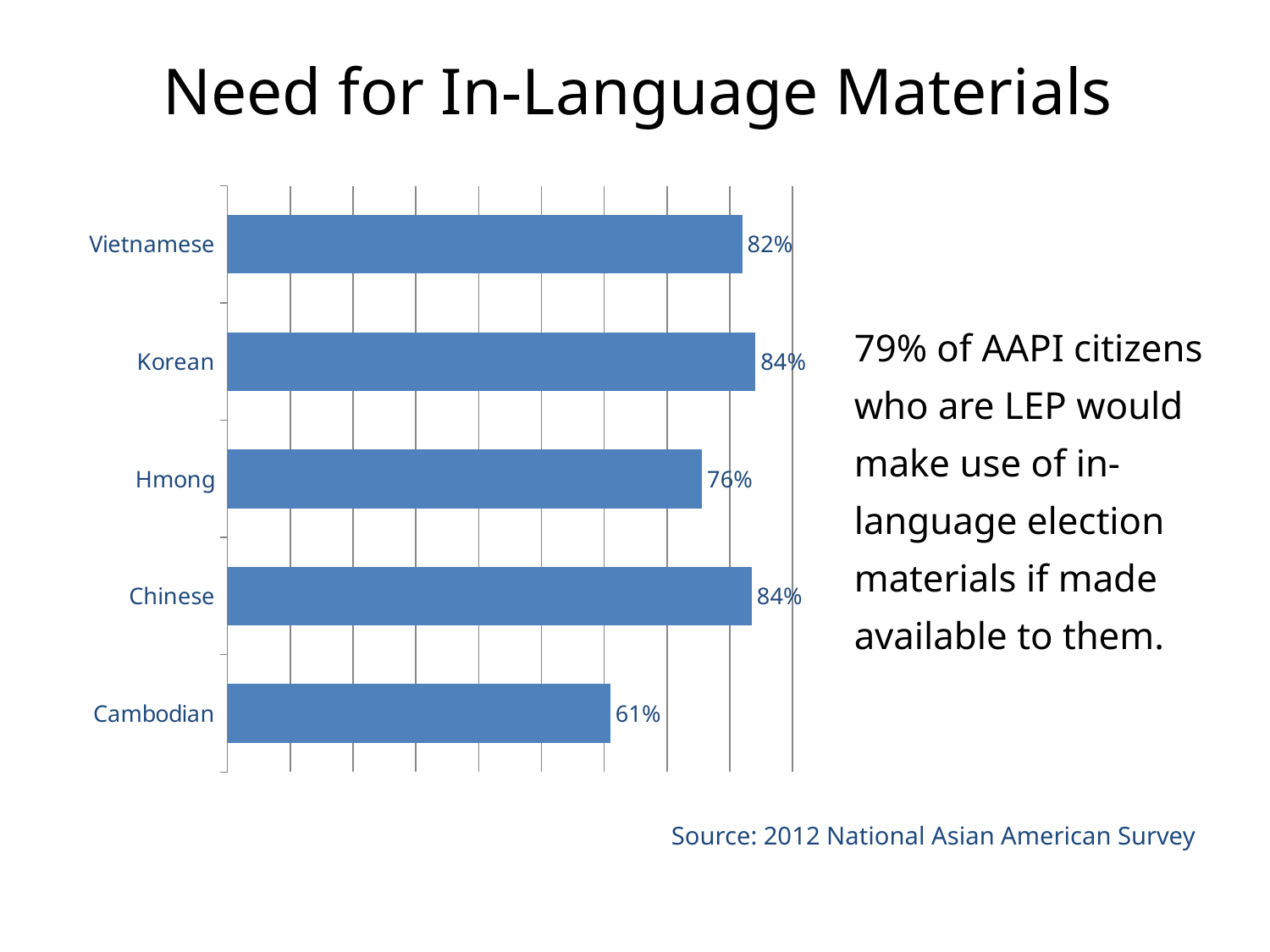
What is the value for Korean? 84% What is the value for Vietnamese? 82% What is the value for Hmong? 76% What is the title of the slide containing the chart? Need for In-Language Materials What is the value for Cambodian? 61% Which category has the lowest value? Cambodian What is the difference between the values for Vietnamese and Hmong? 6% What kind of chart is shown on the slide? Bar chart What is the difference between the values for Korean and Cambodian? 23% Which is larger, the value for Cambodian or the value for Hmong? Hmong Which is larger, the value for Vietnamese or the value for Hmong? Vietnamese How many categories are shown in the chart? 5